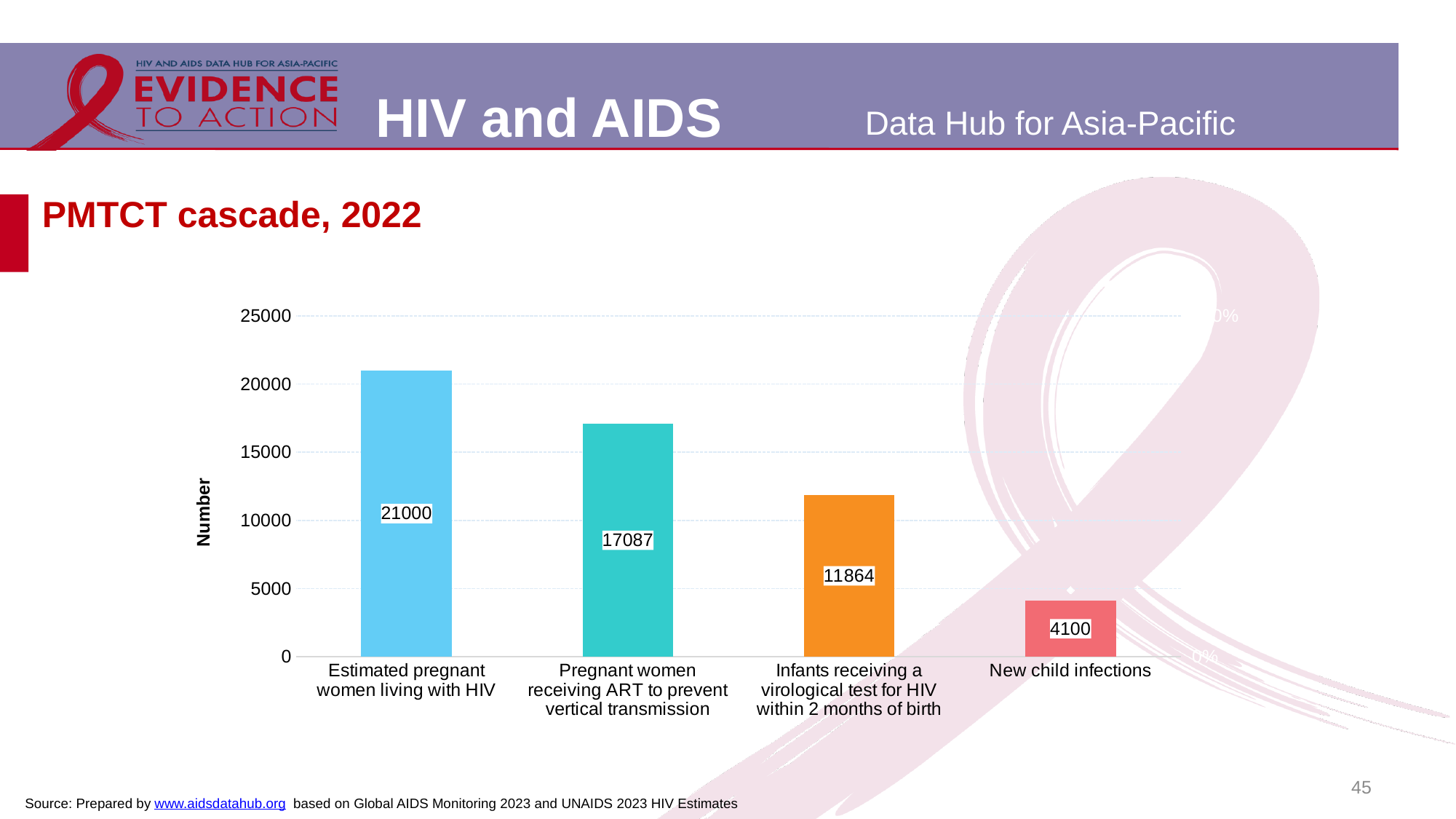
How many categories are shown on the x axis? 4 Which category has the highest value? Estimated pregnant women living with HIV What is the difference between Estimated pregnant women living with HIV and Pregnant women receiving ART to prevent vertical transmission? 3913 What is the value for Estimated pregnant women living with HIV? 21000 What kind of chart is shown on the slide? Bar chart What is the value for Infants receiving a virological test for HIV within 2 months of birth? 11864 What is the value for New child infections? 4100 Which is larger: Pregnant women receiving ART to prevent vertical transmission or Infants receiving a virological test for HIV within 2 months of birth? Pregnant women receiving ART to prevent vertical transmission Do the values rise or fall from left to right along the x axis? Fall What is the value for Pregnant women receiving ART to prevent vertical transmission? 17087 Which category has the lowest value? New child infections What is the difference between Infants receiving a virological test for HIV within 2 months of birth and New child infections? 7764